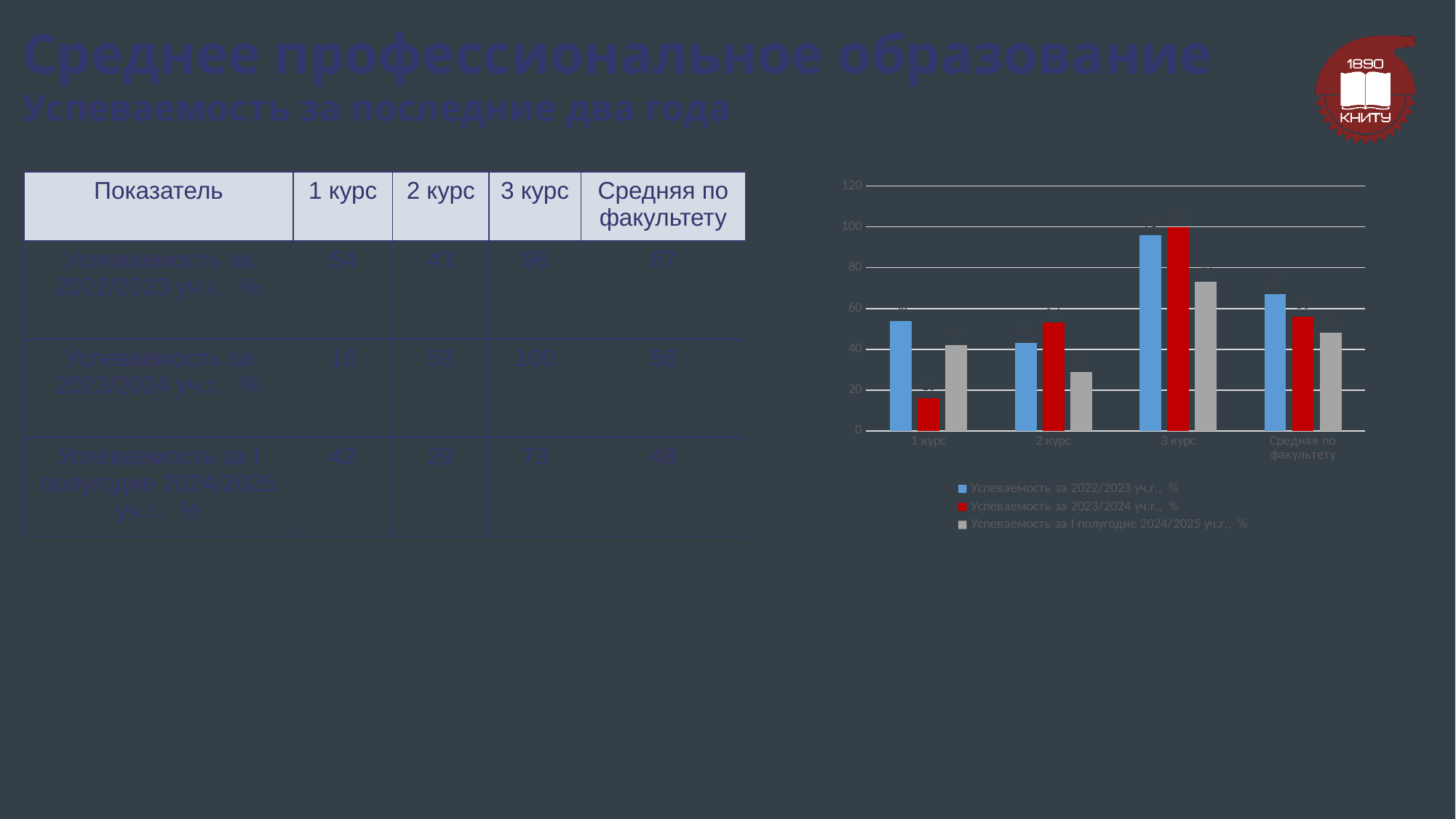
For '1 курс', which series has the larger value: 'Успеваемость за 2022/2023 уч.г., %' or 'Успеваемость за 2023/2024 уч.г., %'? Успеваемость за 2022/2023 уч.г., % What is the value for '3 курс' in the series 'Успеваемость за 2023/2024 уч.г., %'? 100 What kind of chart is shown on the slide? bar chart What colour are the bars for the series 'Успеваемость за 2023/2024 уч.г., %'? red Which category has the highest value for the series 'Успеваемость за 2022/2023 уч.г., %'? 3 курс What is the value for 'Средняя по факультету' in the series 'Успеваемость за 2022/2023 уч.г., %'? 67 Which category has the highest value for the series 'Успеваемость за 2023/2024 уч.г., %'? 3 курс Is the value for '3 курс' in the series 'Успеваемость за 2022/2023 уч.г., %' greater or less than 80? greater How many series does the chart legend list? 3 Which category has the lowest value for the series 'Успеваемость за 2023/2024 уч.г., %'? 1 курс How many categories are shown on the x axis of the chart? 4 Is the value for '2 курс' in the series 'Успеваемость за I полугодие 2024/2025 уч.г., %' greater or less than 40? less